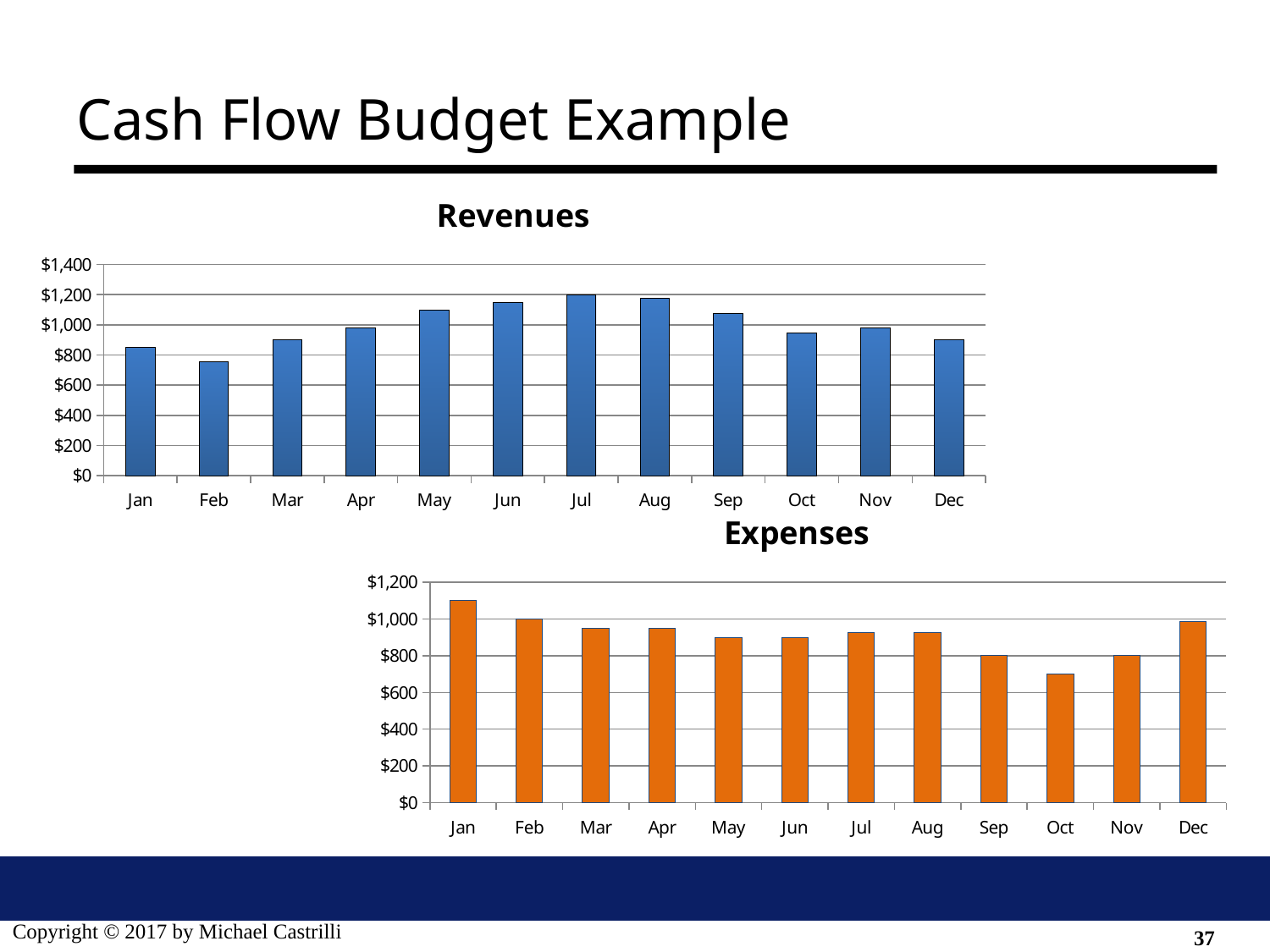
In the Revenues chart, do the values rise or fall from Jan to Jul? rise In the Expenses chart, which month has the lowest expenses? Oct In the Revenues chart, is the value for Jul greater or less than $1,000? greater In the Expenses chart, is the value for Oct greater or less than $800? less In the Revenues chart, which is larger, the value for May or the value for Oct? May In the Revenues chart, which month has the lowest revenue? Feb In the Expenses chart, which month has the highest expenses? Jan What is the title of the chart with the orange bars? Expenses In the Revenues chart, is the value for Feb greater or less than $800? less What kind of chart is the Revenues chart? bar chart How many months are shown on the Expenses chart? 12